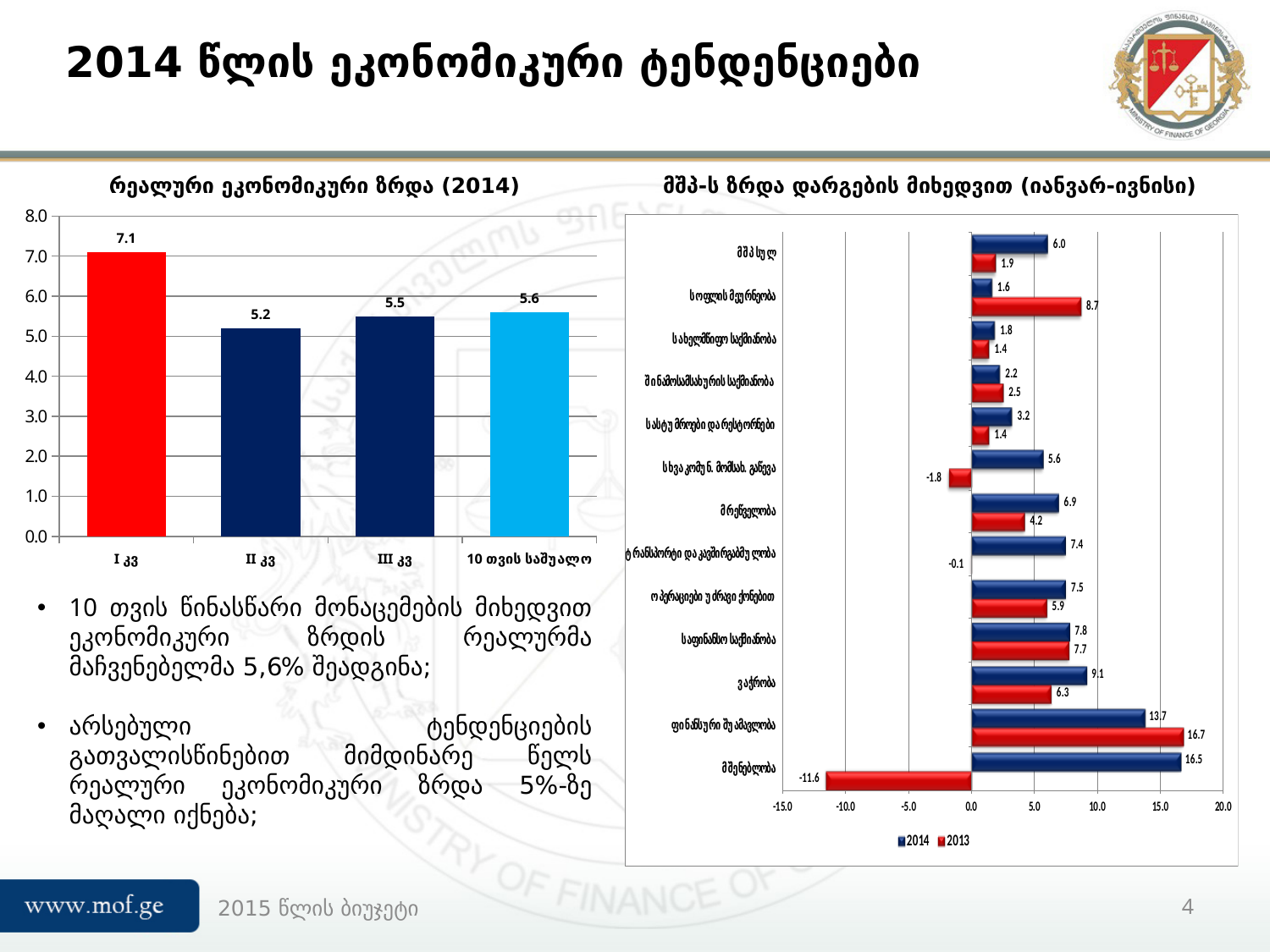
In the left chart 'რეალური ეკონომიკური ზრდა (2014)', what is the difference between I კვ and II კვ? 1.9 In the right chart 'მშპ-ს ზრდა დარგების მიხედვით (იანვარ-ივნისი)', what is the 2013 value for მშენებლობა? -11.6 In the right chart 'მშპ-ს ზრდა დარგების მიხედვით (იანვარ-ივნისი)', which category has the highest 2014 value? მშენებლობა In the right chart 'მშპ-ს ზრდა დარგების მიხედვით (იანვარ-ივნისი)', what is the 2014 value for მშპ სულ? 6.0 In the right chart 'მშპ-ს ზრდა დარგების მიხედვით (იანვარ-ივნისი)', which is larger for სოფლის მეურნეობა, the 2014 value or the 2013 value? 2013 What kind of chart is the right chart 'მშპ-ს ზრდა დარგების მიხედვით (იანვარ-ივნისი)'? bar chart In the left chart 'რეალური ეკონომიკური ზრდა (2014)', what is the value for 10 თვის საშუალო? 5.6 In the left chart 'რეალური ეკონომიკური ზრდა (2014)', how many bars are plotted? 4 In the left chart 'რეალური ეკონომიკური ზრდა (2014)', which category has the lowest value? II კვ In the right chart 'მშპ-ს ზრდა დარგების მიხედვით (იანვარ-ივნისი)', what is the difference between the 2014 and 2013 values for ვაჭრობა? 2.8 In the right chart 'მშპ-ს ზრდა დარგების მიხედვით (იანვარ-ივნისი)', how many series does the legend list? 2 In the left chart 'რეალური ეკონომიკური ზრდა (2014)', what is the value for I კვ? 7.1